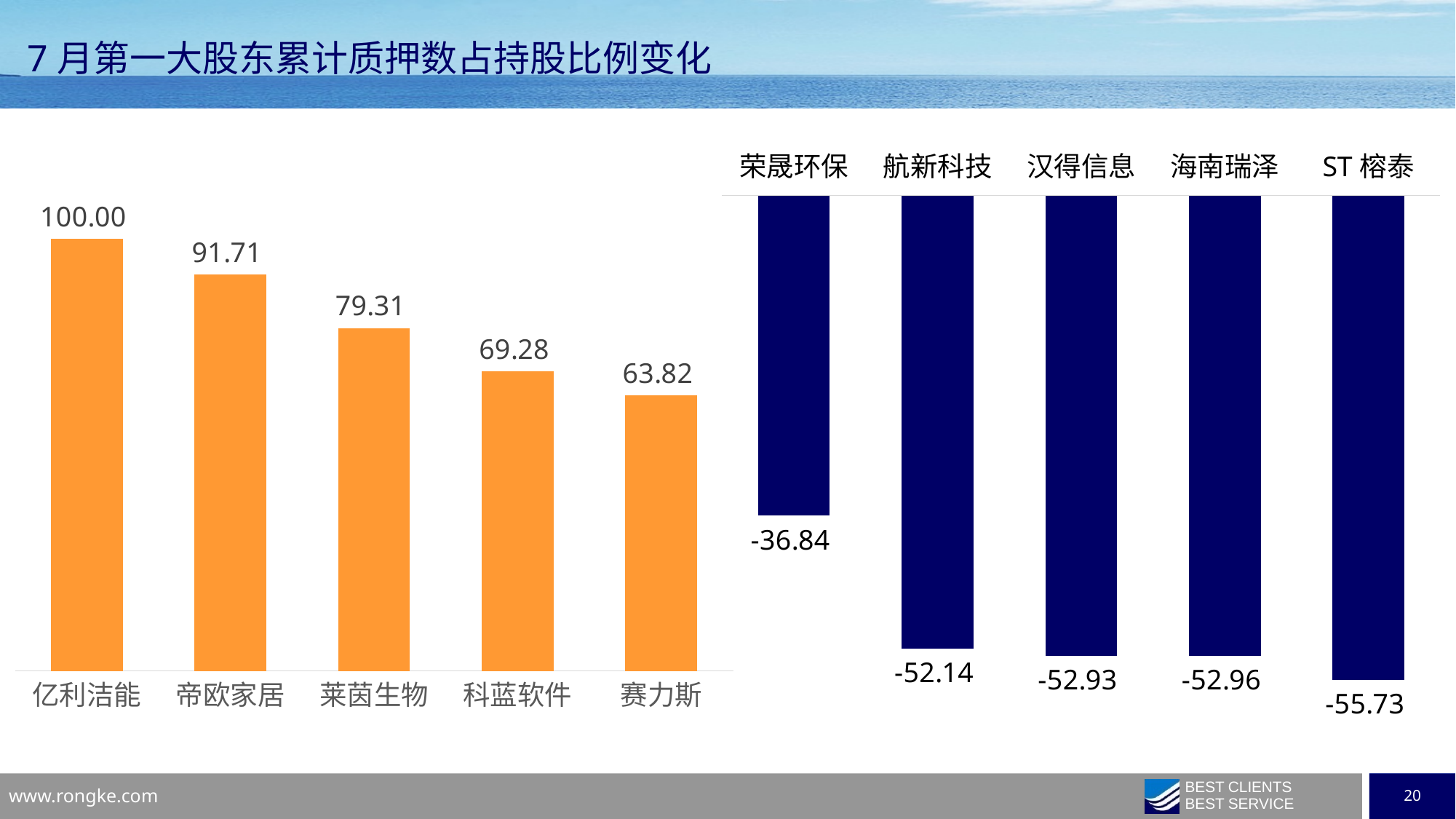
In the left chart, which is larger, the value for 莱茵生物 or 赛力斯? 莱茵生物 In the left chart, what is the value for 亿利洁能? 100.00 In the right chart, what is the value for 航新科技? -52.14 How many categories are shown in the right chart? 5 In the right chart, which category has the largest decline? ST 榕泰 In the left chart, what is the difference between the values for 帝欧家居 and 科蓝软件? 22.43 In the right chart, what is the value for ST 榕泰? -55.73 In the left chart, what is the value for 莱茵生物? 79.31 In the left chart, do the values rise or fall from left to right? Fall In the right chart, which category has the smallest decline? 荣晟环保 In the left chart, which category has the lowest value? 赛力斯 What kind of chart is the left chart? Bar chart